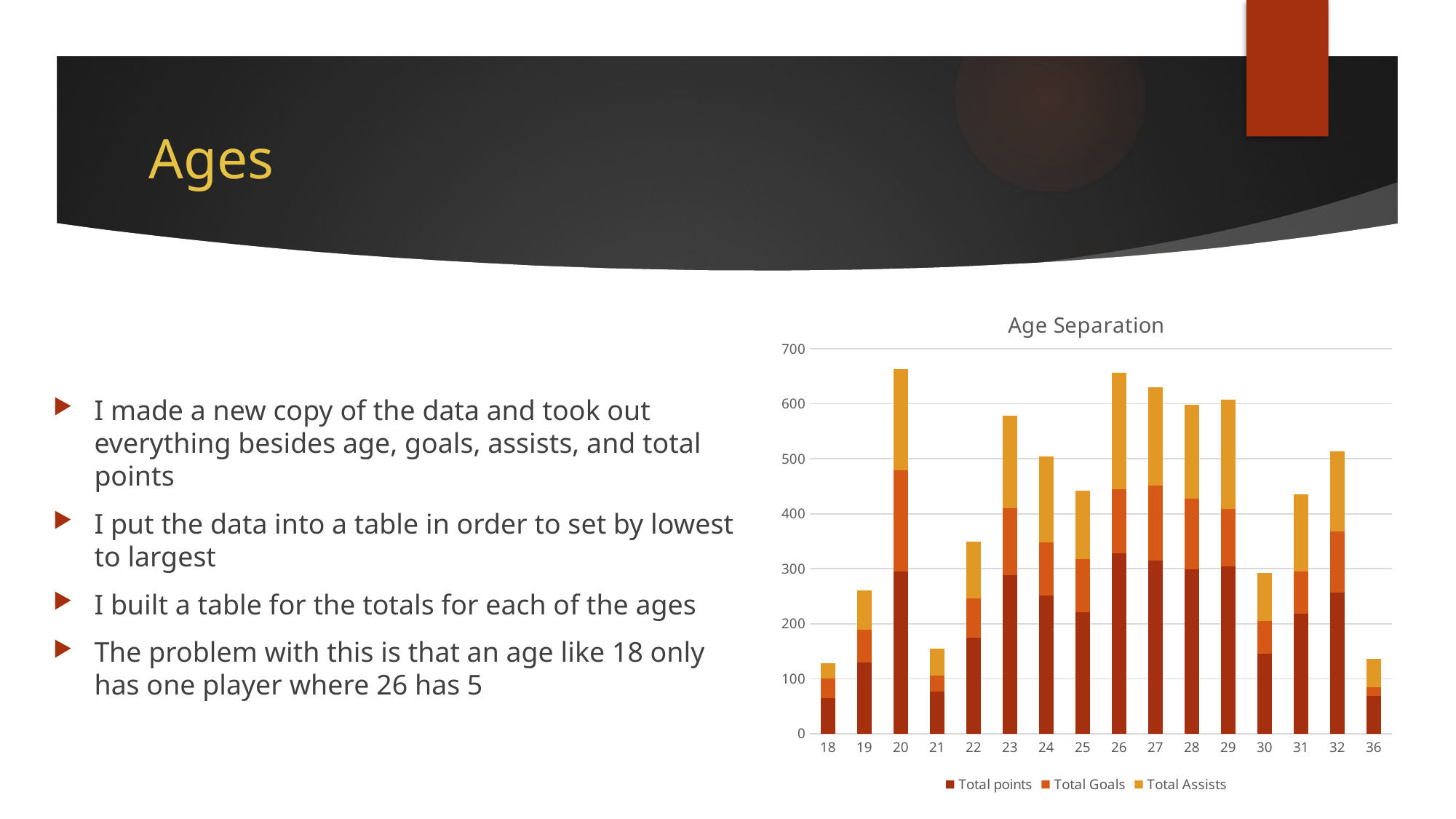
Which series are listed in the legend? Total points, Total Goals, Total Assists How many age categories are shown on the x axis? 16 Which has a larger total stacked value, age 19 or age 22? Age 22 What is the title of the chart? Age Separation Is the total stacked value for age 21 greater or less than 200? less Is the total stacked value for age 20 greater or less than 600? greater Is the total stacked value for age 32 greater or less than 500? greater How many series does the legend list? 3 Which has a larger total stacked value, age 23 or age 24? Age 23 What kind of chart is shown on the slide? Stacked bar chart